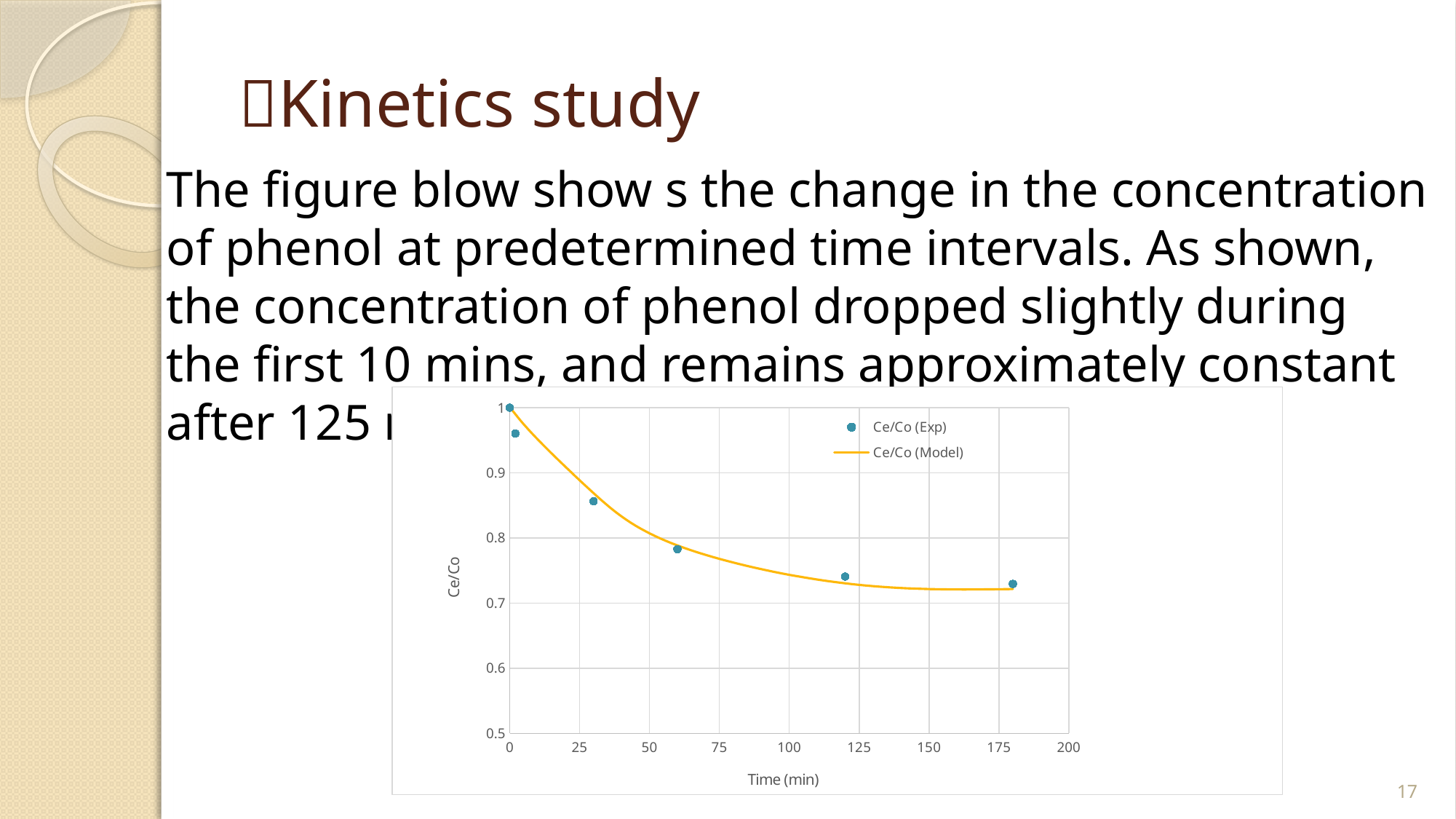
How many experimental (Ce/Co (Exp)) data points are plotted on the chart? 6 What is the Ce/Co (Exp) value at time 0 min? 1 At which time is the Ce/Co (Exp) value highest? 0 min What are the two series named in the chart legend? Ce/Co (Exp) and Ce/Co (Model) Is the Ce/Co (Exp) value at 60 min greater or less than 0.8? less How many series does the chart legend list? 2 What is the label of the x axis of the chart? Time (min) What kind of chart is shown on the slide? Scatter chart with a fitted line Is the Ce/Co (Exp) value at 30 min greater or less than 0.8? greater Do the Ce/Co values rise or fall as time increases along the x axis? Fall Which has the larger Ce/Co (Exp) value, the point at 30 min or the point at 60 min? 30 min Is the Ce/Co (Exp) value at 180 min greater or less than 0.7? greater